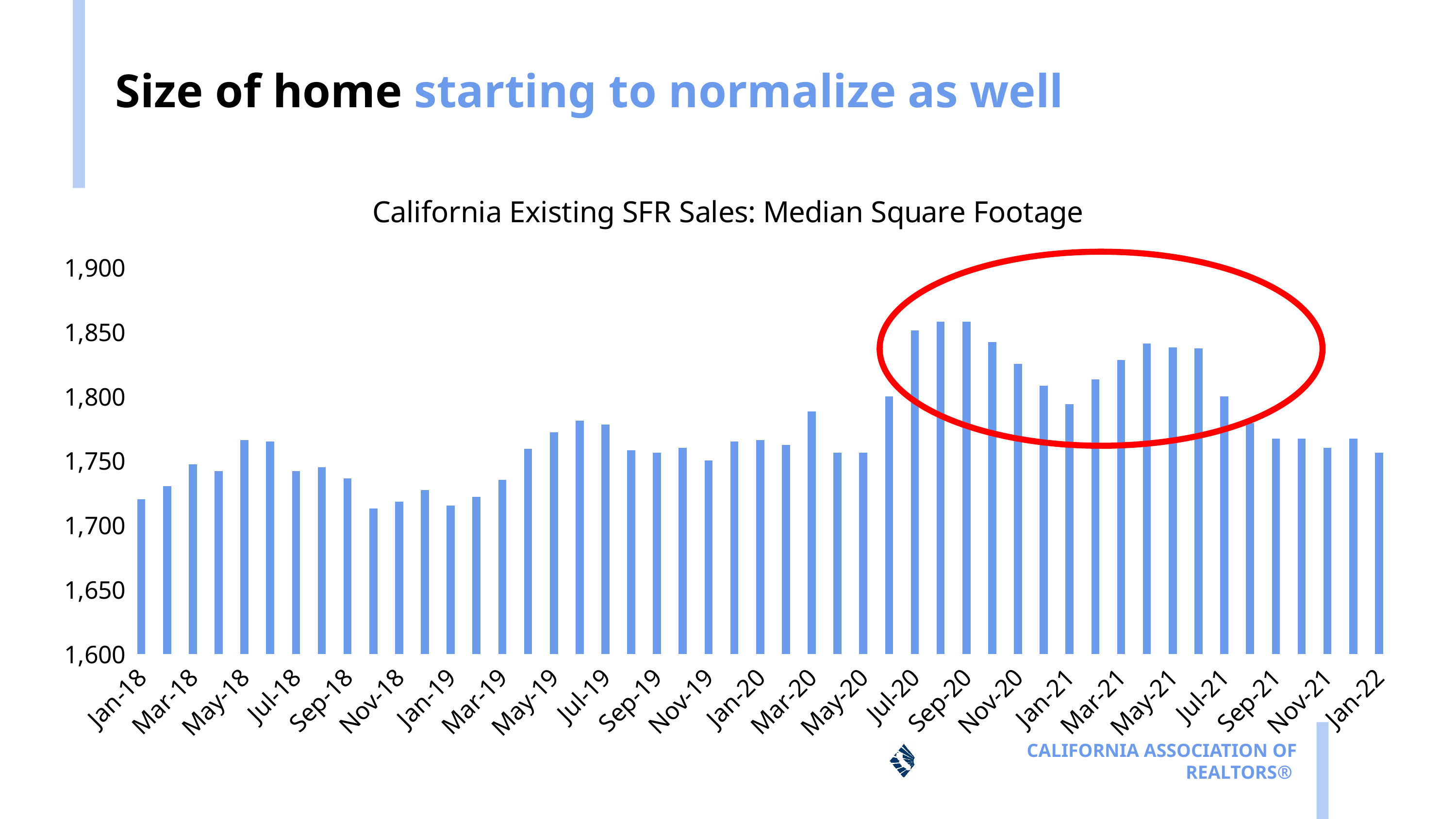
Is the value for Mar-20 greater or less than 1,750? greater Is the value for Jul-19 greater or less than 1,750? greater What is the title of the chart? California Existing SFR Sales: Median Square Footage Is the value for Jan-18 greater or less than 1,750? less Which is larger, the value for Jul-19 or the value for Jan-19? Jul-19 Which is larger, the value for Sep-20 or the value for Jan-18? Sep-20 What kind of chart is shown on the slide? bar chart Do the values rise or fall from Sep-20 to Jan-21? fall How many bars are plotted in the chart? 49